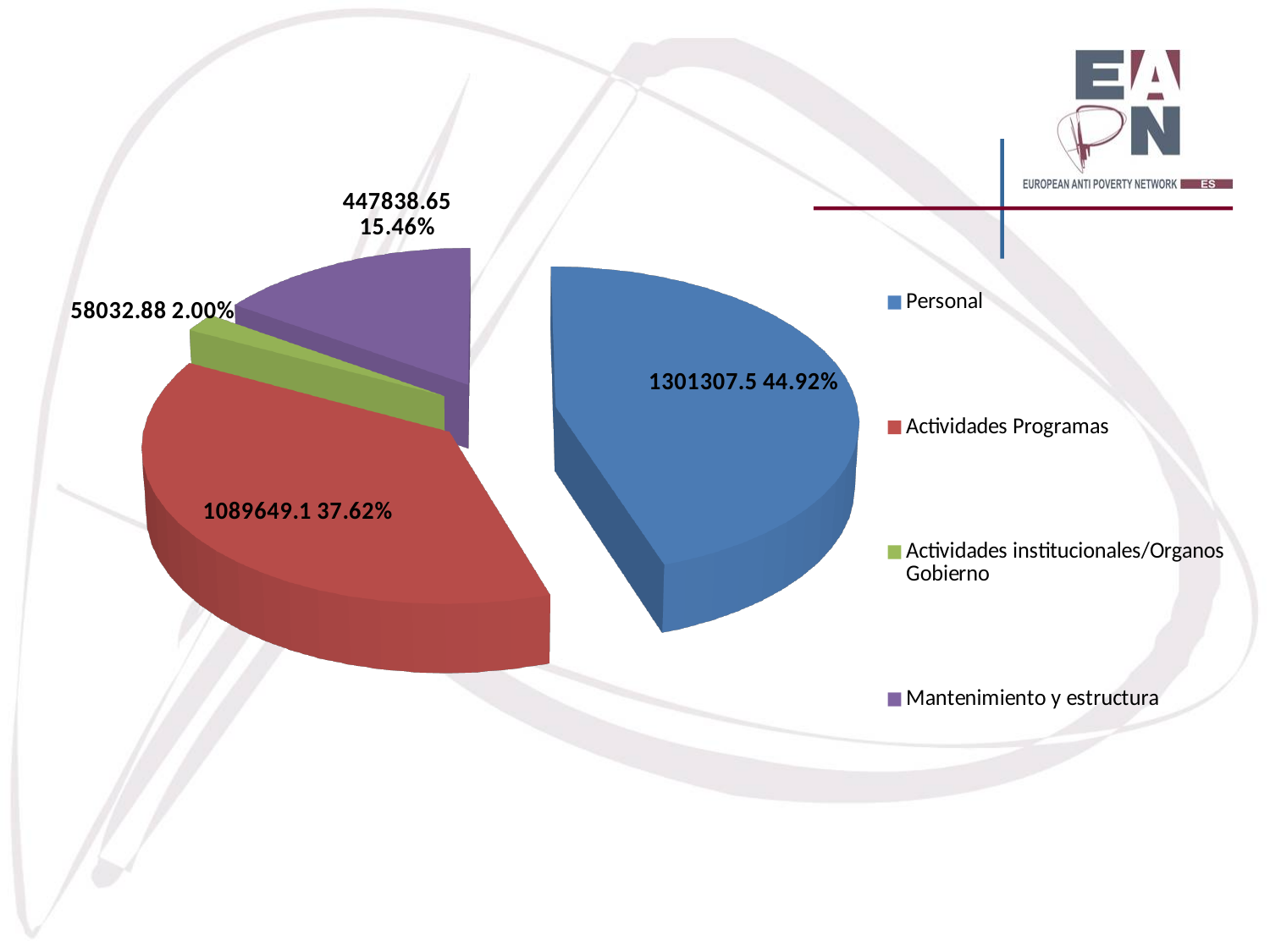
What kind of chart is shown on the slide? pie chart How many categories does the pie chart show? 4 What is the difference between the values for Personal and Actividades Programas? 211658.4 What percentage share does Personal have? 44.92% Which category has the largest slice? Personal Which is larger, Actividades Programas or Mantenimiento y estructura? Actividades Programas What is the value for Mantenimiento y estructura? 447838.65 Which category has the smallest slice? Actividades institucionales/Organos Gobierno What is the value for Personal? 1301307.5 What percentage share does Actividades Programas have? 37.62% What colour is the slice for Mantenimiento y estructura? purple What percentage share does Actividades institucionales/Organos Gobierno have? 2.00%